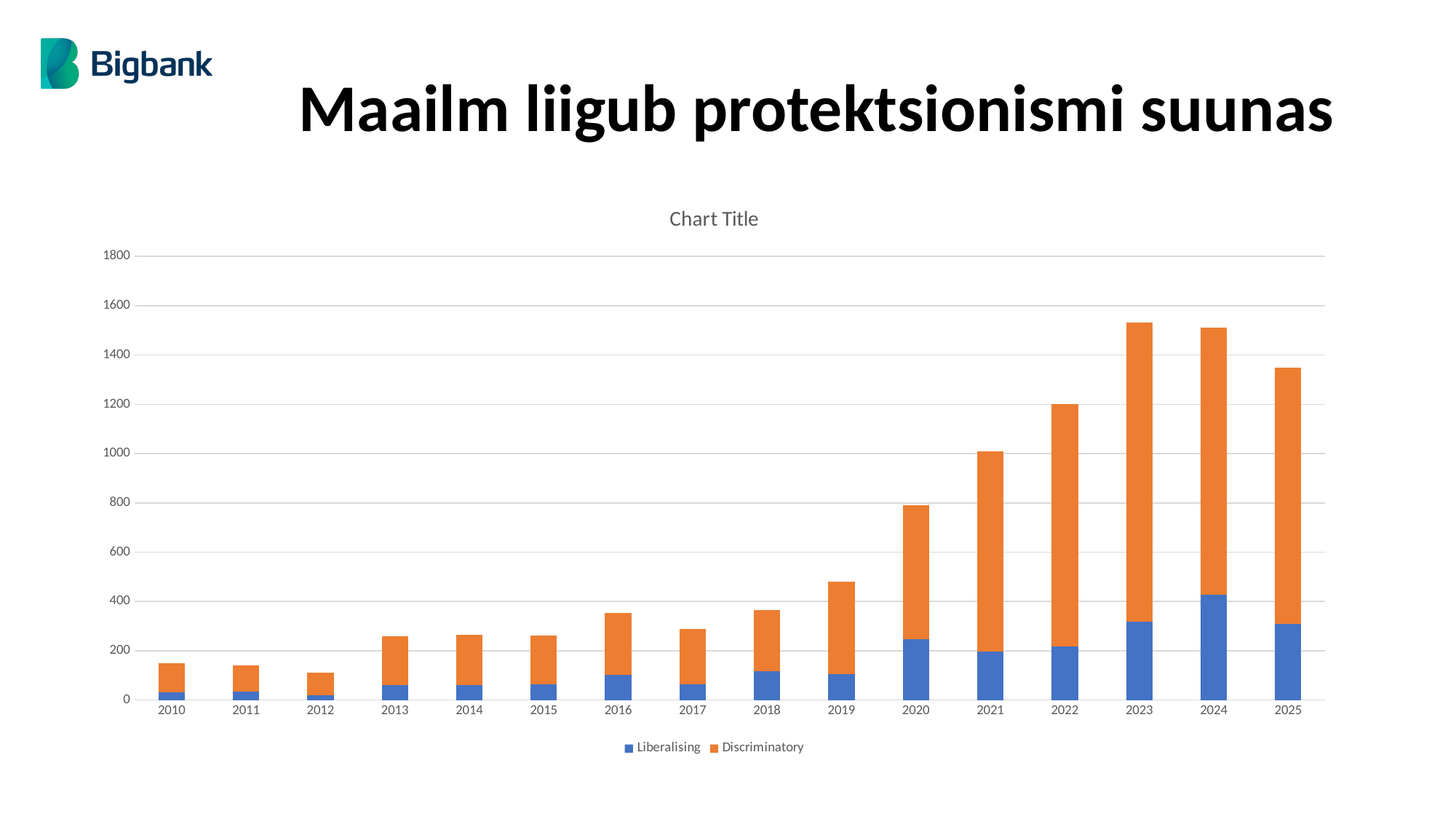
Which year has the highest Liberalising value in the chart? 2024 Is the total bar for 2025 greater or less than 1200? greater Which year has the lowest total bar in the chart? 2012 Which year has the larger total bar, 2021 or 2019? 2021 How many years are shown on the x axis of the chart? 16 Is the total bar for 2019 greater or less than 600? less Which series is shown in orange in the chart? Discriminatory Is the total bar for 2010 greater or less than 200? less What kind of chart is shown on the slide? Stacked bar chart Do the total bars generally rise or fall from 2010 to 2023? rise How many series does the chart legend list? 2